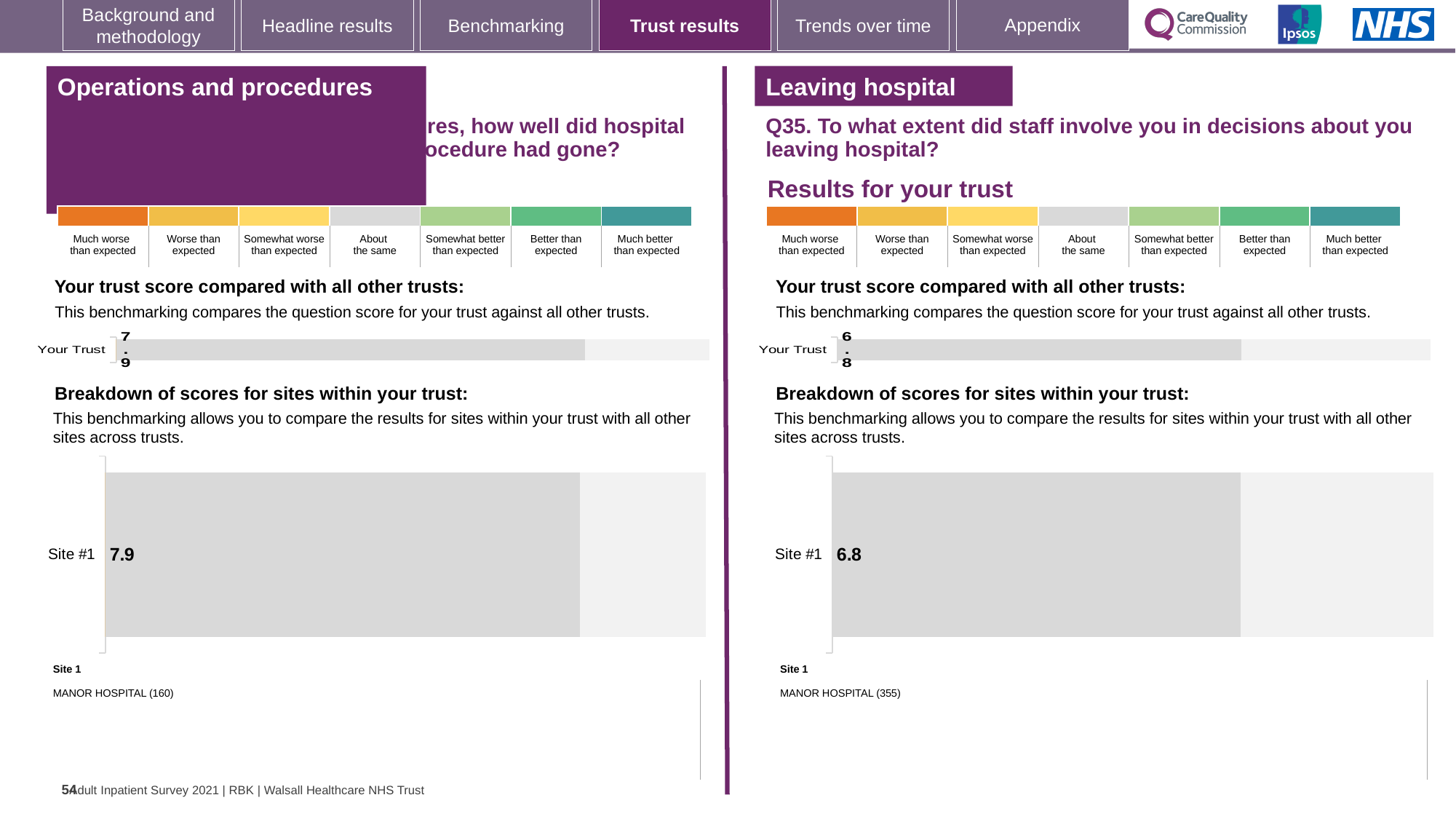
How many categories are shown in the colour scale above the Your Trust chart on the Leaving hospital panel? 7 What kind of chart is used to show the Site #1 score on the Leaving hospital panel? Bar chart On the Leaving hospital panel, what is the name of Site 1 listed below the site breakdown chart? MANOR HOSPITAL (355) On the Leaving hospital panel, what score is shown for Site #1 in the breakdown of scores for sites? 6.8 What is the difference between the Your Trust score on the Operations and procedures panel and the Your Trust score on the Leaving hospital panel? 1.1 Which panel shows the higher Your Trust score, Operations and procedures or Leaving hospital? Operations and procedures On the Operations and procedures panel, what is the score shown for Your Trust? 7.9 Which panel shows the higher Site #1 score, Operations and procedures or Leaving hospital? Operations and procedures On the Leaving hospital panel, what is the score shown for Your Trust? 6.8 On the Operations and procedures panel, what score is shown for Site #1 in the breakdown of scores for sites? 7.9 How many sites are shown in the breakdown of scores for sites on the Operations and procedures panel? 1